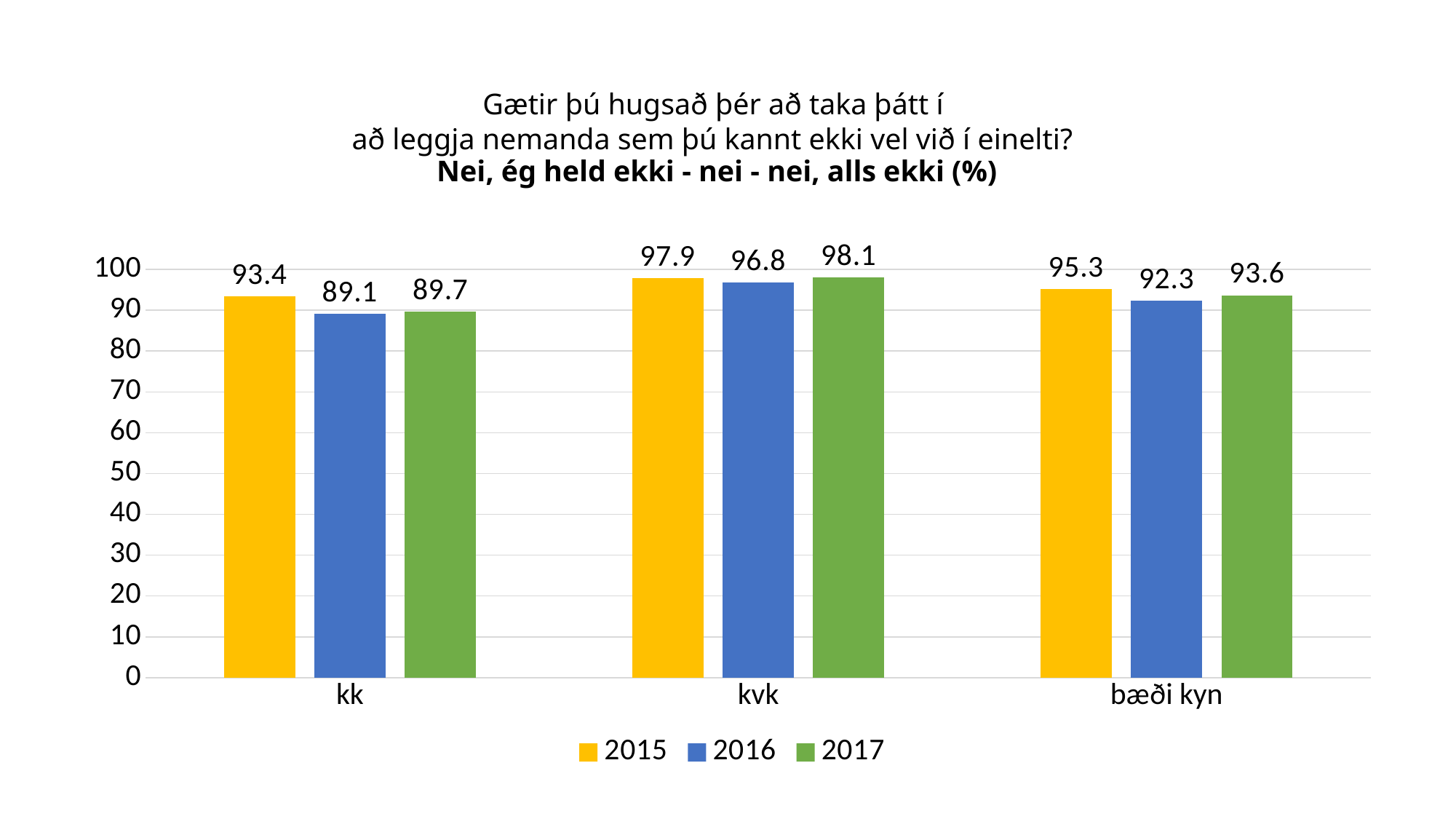
Which category has the highest value in 2016? kvk Which colour represents the 2017 series? green What is the value for kk in 2015? 93.4 How many categories are shown on the x axis? 3 Is the value for kk in 2016 greater or less than 90? less What is the value for bæði kyn in 2016? 92.3 Which is larger, the 2015 value for kvk or the 2017 value for kvk? 2017 What is the value for kvk in 2017? 98.1 How many series does the legend list? 3 What is the difference between the 2015 and 2016 values for kk? 4.3 What kind of chart is shown? bar chart Which category has the lowest value in 2017? kk